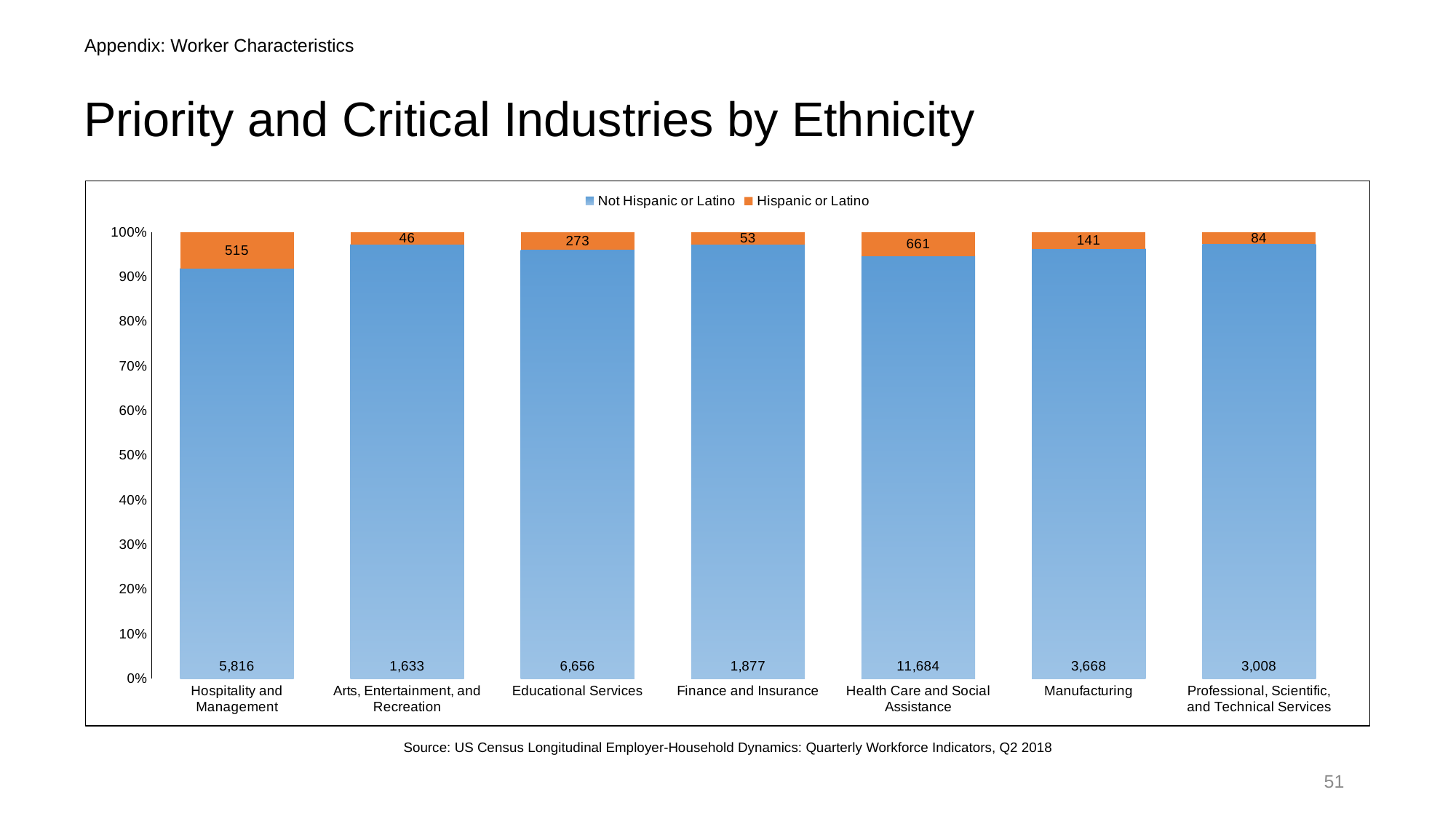
What kind of chart is shown on the slide? Stacked bar chart Which is larger, the Hispanic or Latino value for Educational Services or for Manufacturing? Educational Services Is the Not Hispanic or Latino share of the Hospitality and Management bar greater or less than 90%? greater What is the difference between the Not Hispanic or Latino values for Educational Services and Hospitality and Management? 840 What is the Hispanic or Latino value for Manufacturing? 141 Which industry has the lowest Hispanic or Latino value? Arts, Entertainment, and Recreation What is the Hispanic or Latino value for Hospitality and Management? 515 What is the Not Hispanic or Latino value for Health Care and Social Assistance? 11,684 How many industries are shown on the x axis? 7 What is the total of the two values in the Finance and Insurance bar? 1,930 Which industry has the highest Not Hispanic or Latino value? Health Care and Social Assistance How many series does the legend list? 2